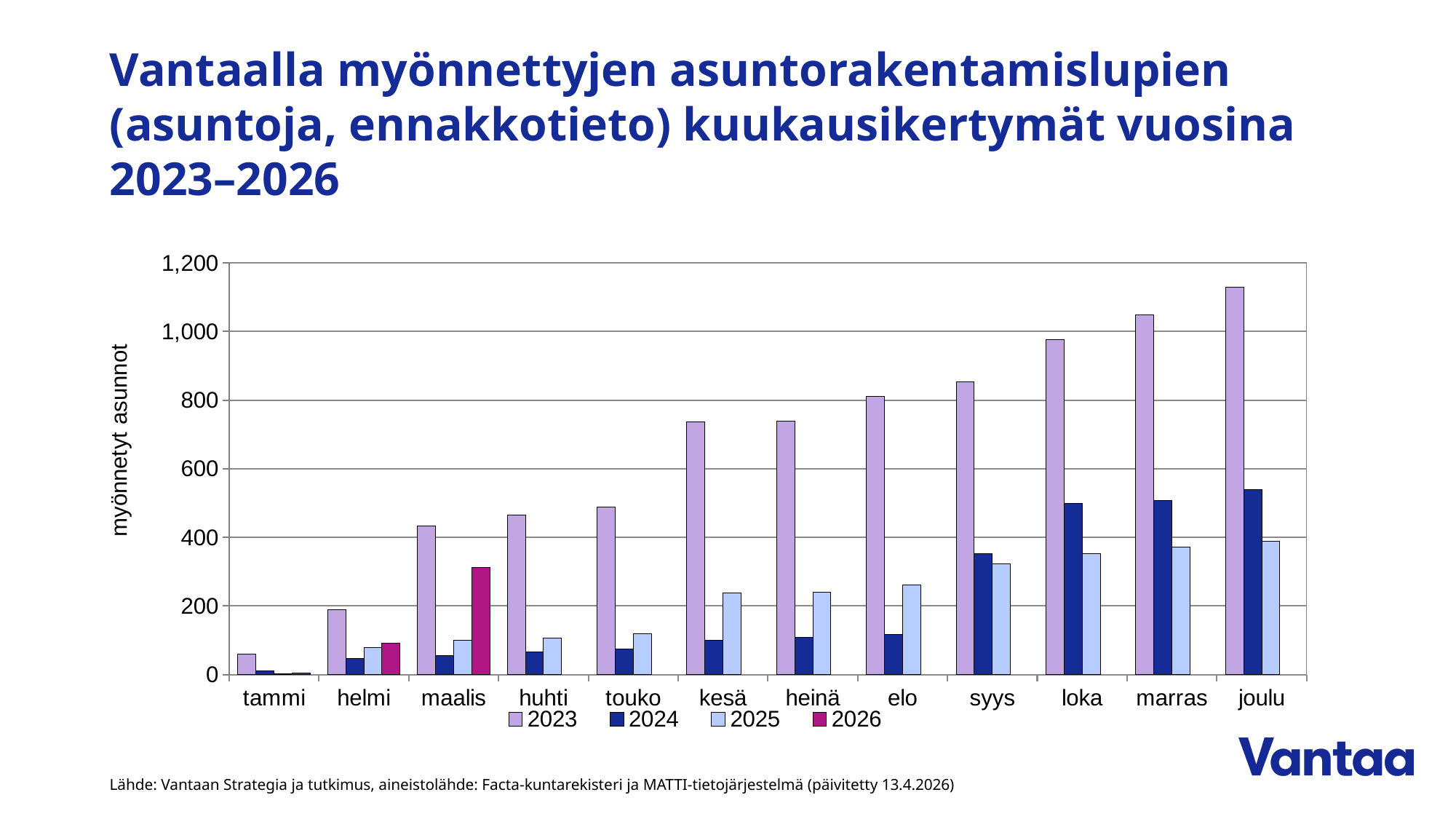
For loka, which series has the larger value, 2024 or 2025? 2024 Is the 2024 value for syys greater or less than 400? less What kind of chart is shown on the slide? bar chart In which month is the 2023 value highest? joulu In which month is the 2023 value lowest? tammi Is the 2023 value for joulu greater or less than 1,000? greater How many series does the legend list? 4 For maalis, which series has the larger value, 2025 or 2026? 2026 Is the 2023 value for kesä greater or less than 600? greater How many months are shown on the x axis? 12 Do the 2023 values rise or fall from tammi to joulu? rise